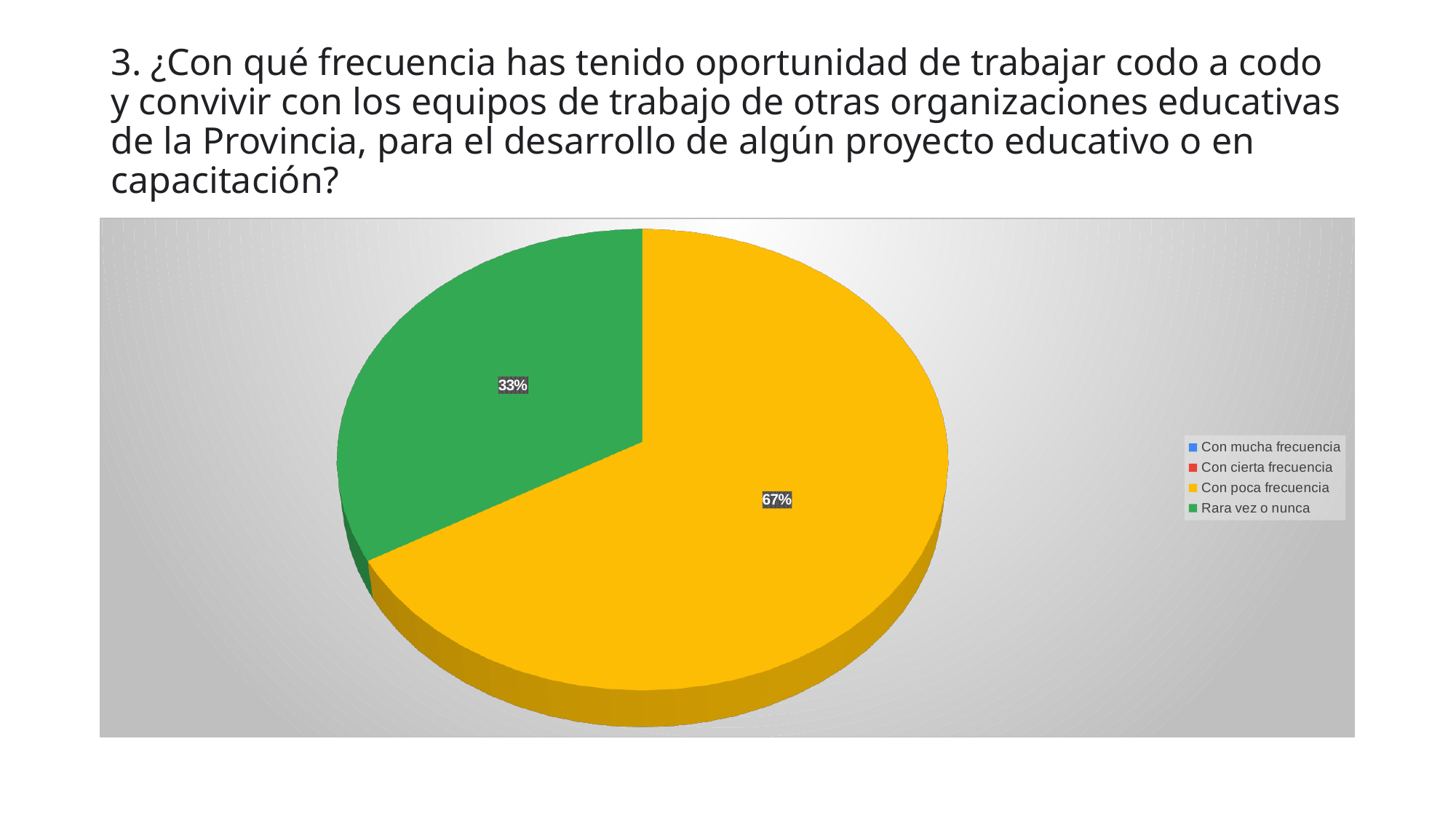
How many slices are visible in the pie? 2 Which of the two visible slices is larger, "Con poca frecuencia" or "Rara vez o nunca"? Con poca frecuencia What colour is the "Con poca frecuencia" slice? yellow What share of the pie does "Con poca frecuencia" represent? 67% Which legend entry corresponds to the 33% slice? Rara vez o nunca How many entries does the legend list? 4 What kind of chart is shown on the slide? pie chart Which category has the largest slice of the pie? Con poca frecuencia What is the difference in percentage points between the "Con poca frecuencia" slice and the "Rara vez o nunca" slice? 34 What colour is the "Rara vez o nunca" slice? green What share of the pie does "Rara vez o nunca" represent? 33%